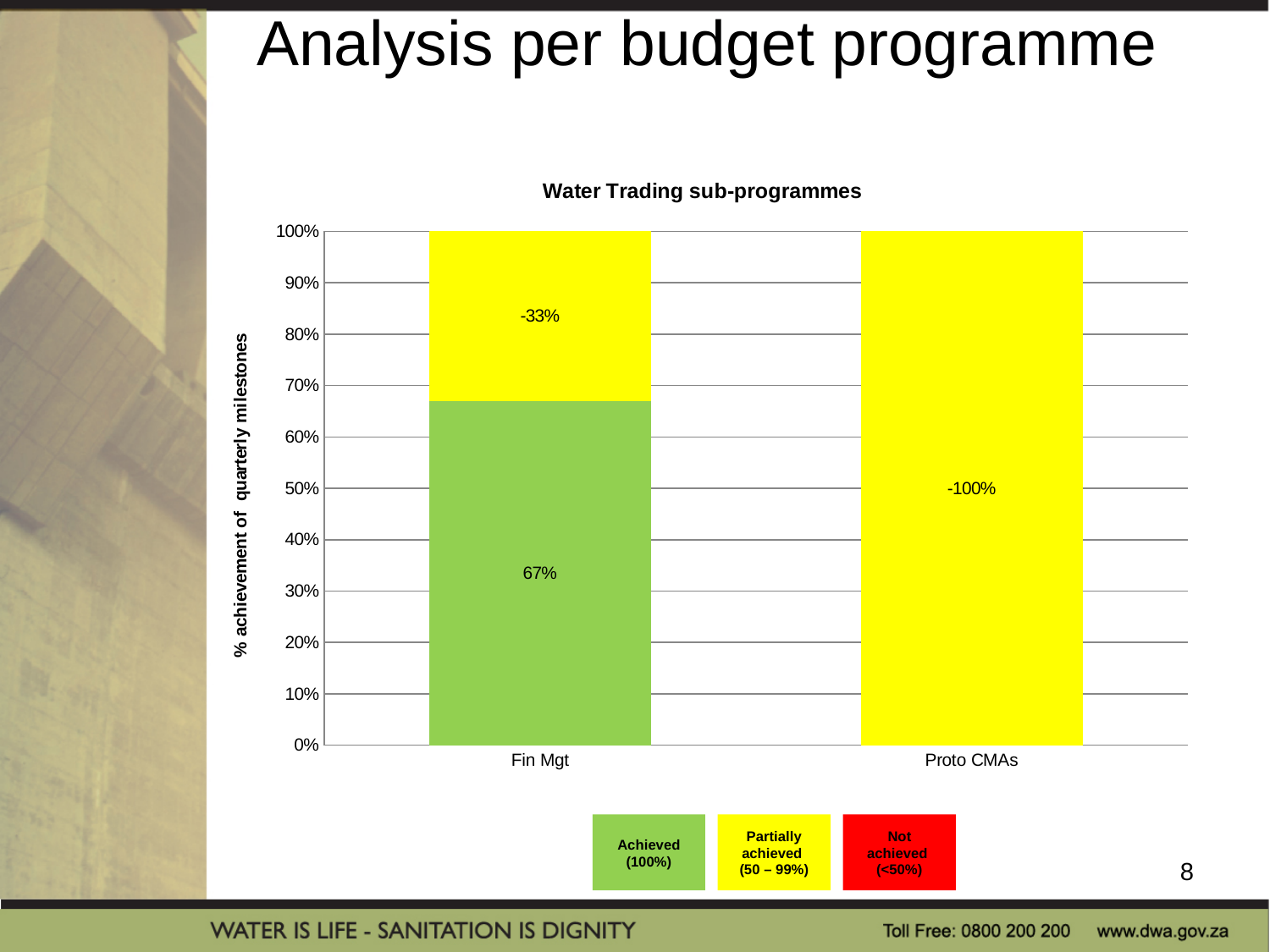
What is the title of the chart? Water Trading sub-programmes Which category has a green (Achieved) segment in the chart? Fin Mgt Is the green (Achieved) segment for Fin Mgt greater or less than 50% on the axis? greater What is the highest value shown on the y axis of the chart? 100% What kind of chart is shown on the slide? stacked bar chart What is the data label on the yellow (Partially achieved) segment for Fin Mgt? -33% How many categories are shown on the x axis of the chart? 2 Which category has the larger yellow (Partially achieved) segment, Fin Mgt or Proto CMAs? Proto CMAs Which category has the smaller green (Achieved) segment, Fin Mgt or Proto CMAs? Proto CMAs What is the data label on the green (Achieved) segment for Fin Mgt? 67% What is the data label on the yellow (Partially achieved) segment for Proto CMAs? -100%